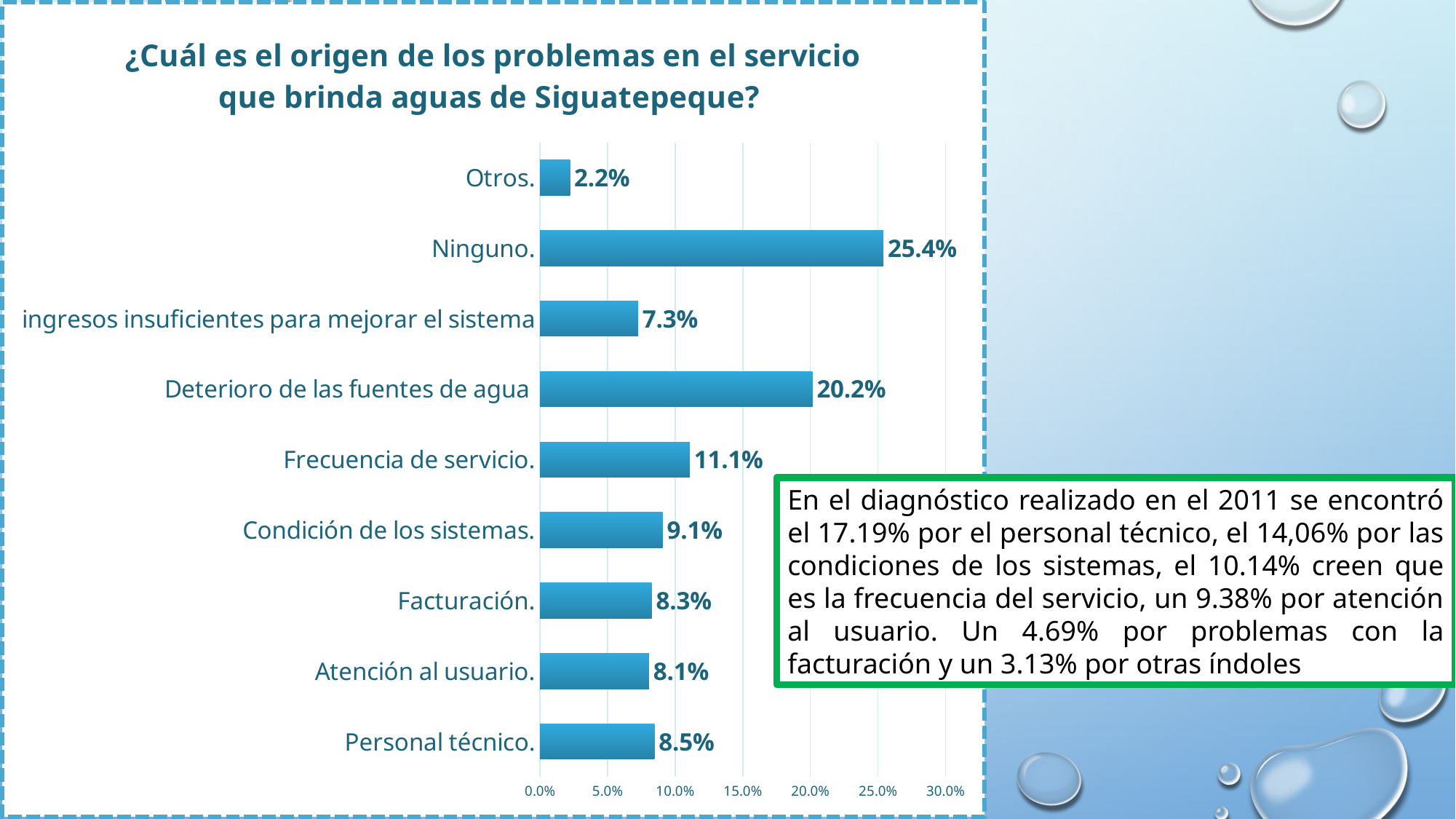
What is the value for "Personal técnico."? 8.5% What kind of chart is shown on the slide? bar chart What is the difference between the values for "Ninguno." and "Deterioro de las fuentes de agua"? 5.2% What is the value for "Frecuencia de servicio."? 11.1% What is the title of the chart? ¿Cuál es el origen de los problemas en el servicio que brinda aguas de Siguatepeque? Which is larger, the value for "Condición de los sistemas." or the value for "Facturación."? Condición de los sistemas. Which category has the lowest value? Otros. What is the value for "Ninguno."? 25.4% How many categories are shown in the chart? 9 What is the value for "Deterioro de las fuentes de agua"? 20.2% Is the value for "Deterioro de las fuentes de agua" greater or less than 15.0%? greater Which category has the highest value? Ninguno.